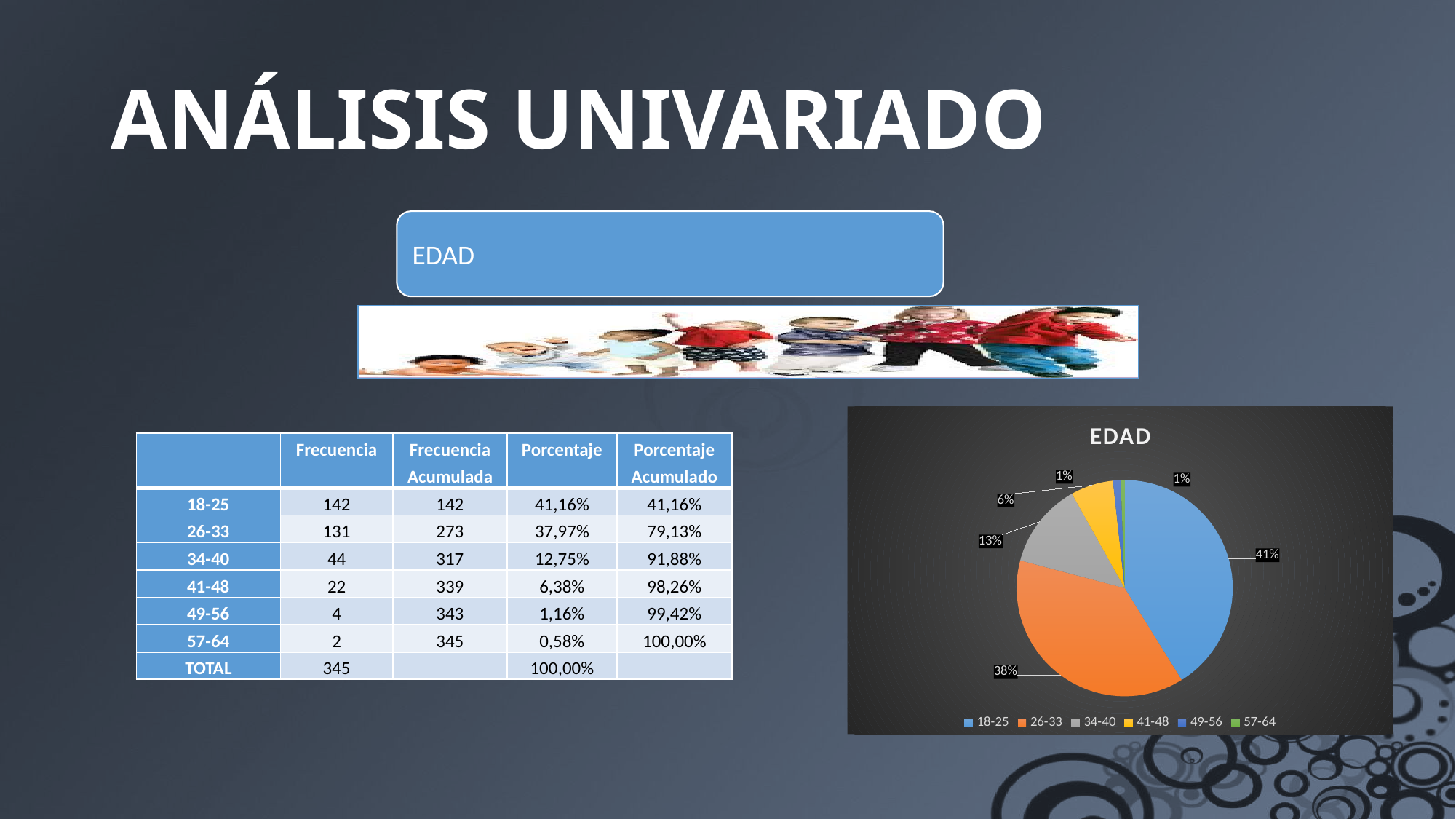
What is the difference in percentage points between the 34-40 slice and the 41-48 slice? 7% What is the title of the chart? EDAD Which colour represents the 26-33 category in the pie chart? orange Which category has the largest slice of the pie? 18-25 What share of the pie does the 41-48 slice represent? 6% What is the difference in percentage points between the 18-25 slice and the 26-33 slice? 3% What share of the pie does the 34-40 slice represent? 13% What share of the pie does the 26-33 slice represent? 38% What type of chart is shown on the slide? pie chart Which is larger in the pie chart, the 34-40 slice or the 41-48 slice? 34-40 How many categories does the legend of the pie chart list? 6